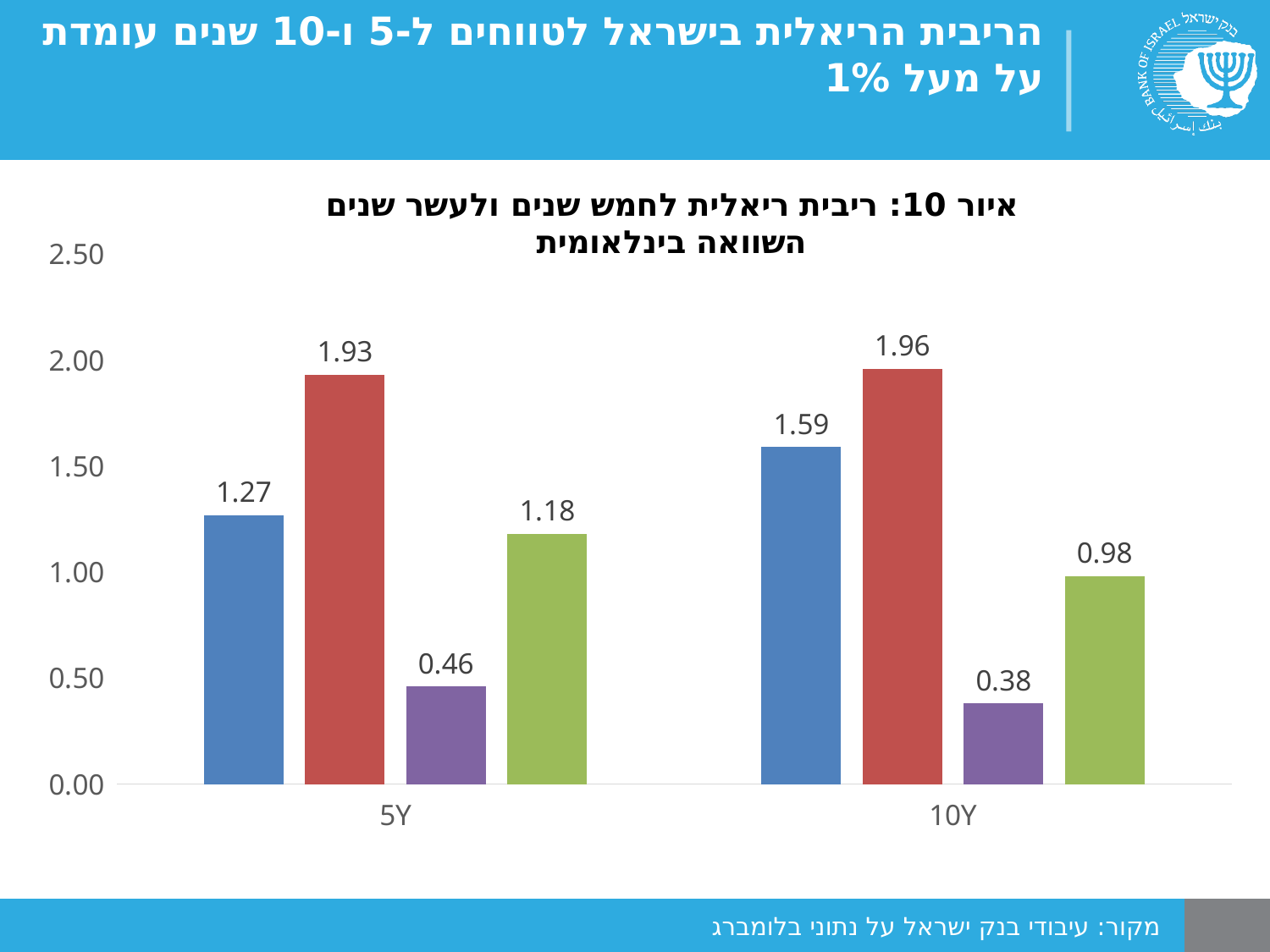
Which is larger: the green bar in the 5Y group or the green bar in the 10Y group? the green bar in the 5Y group (1.18) How many categories are shown on the x axis? 2 What is the difference between the blue bar in the 10Y group and the blue bar in the 5Y group? 0.32 What type of chart is shown on the slide? bar chart How many bars are shown in each category group? 4 What is the value of the green bar in the 5Y group? 1.18 Is the value of the purple bar in the 5Y group greater or less than 0.50? less What is the value of the red bar in the 5Y group? 1.93 Which bar has the lowest value in the 5Y group? the purple bar (0.46) Which bar has the highest value in the 10Y group? the red bar (1.96) What is the value of the purple bar in the 10Y group? 0.38 What is the value of the blue bar in the 10Y group? 1.59